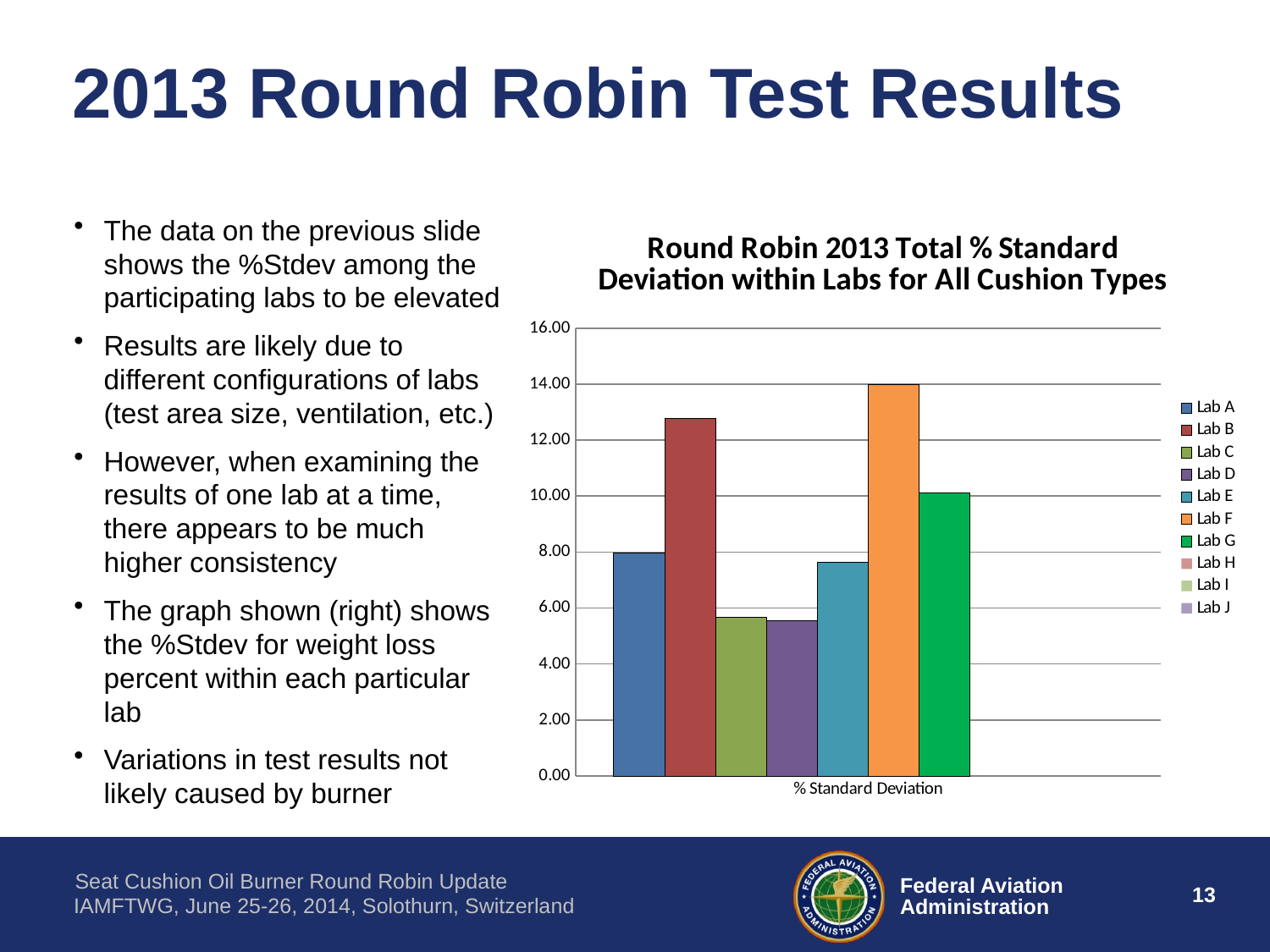
Which is larger, the value for Lab B or the value for Lab G? Lab B Is the value for Lab C greater or less than 6.00? less What is the title of the chart? Round Robin 2013 Total % Standard Deviation within Labs for All Cushion Types Which is larger, the value for Lab A or the value for Lab E? Lab A What kind of chart is shown on the slide? bar chart Which lab has the highest % standard deviation in the chart? Lab F What is the label shown on the x axis of the chart? % Standard Deviation Is the value for Lab B greater or less than 12.00? greater How many bars are plotted in the chart? 7 Is the value for Lab E greater or less than 8.00? less How many series does the legend of the chart list? 10 Which is larger, the value for Lab G or the value for Lab E? Lab G